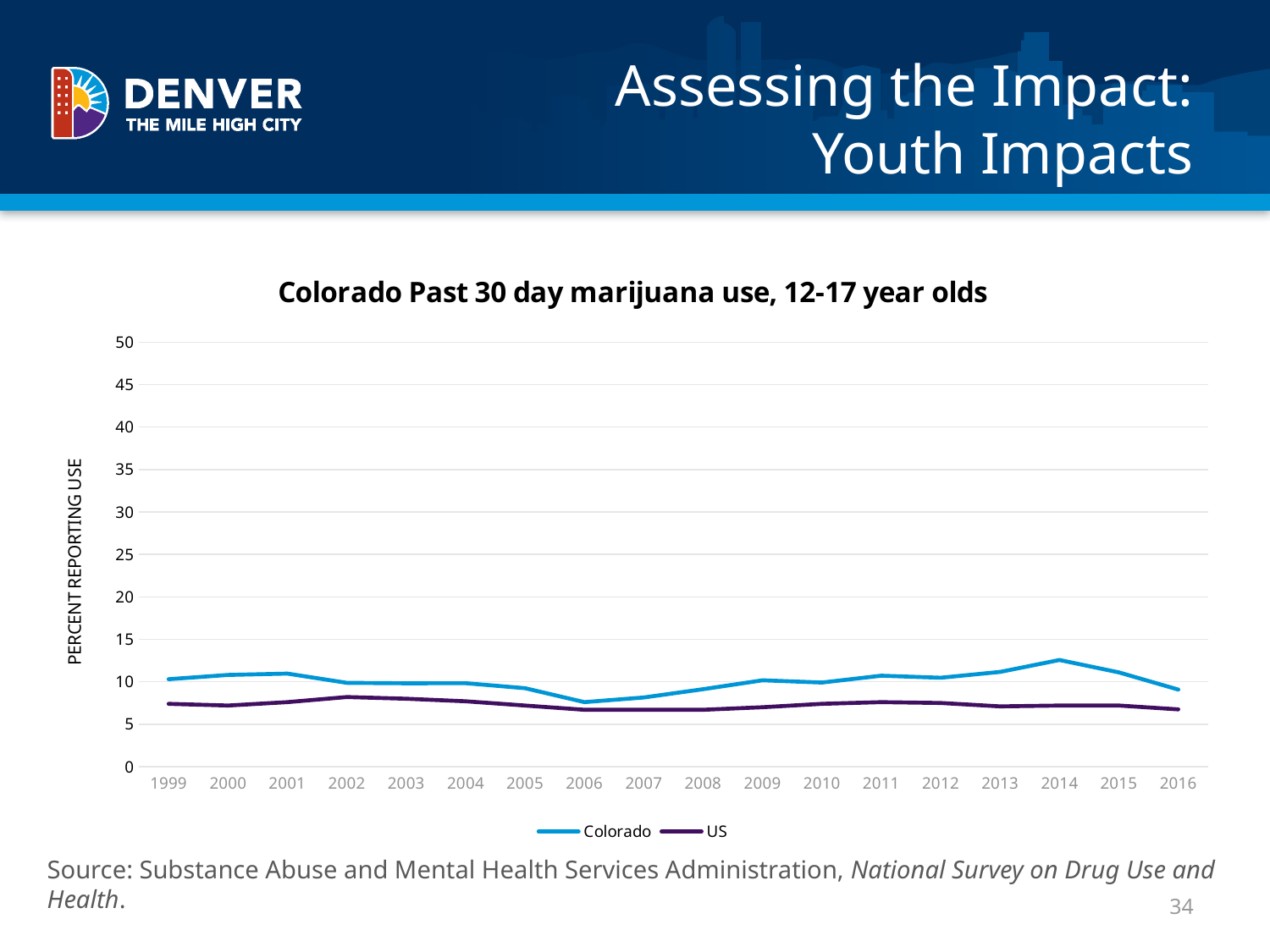
Which two series are shown in the legend? Colorado and US In which year does the Colorado line reach its lowest value? 2006 In 2014, which series has the higher value, Colorado or US? Colorado Does the Colorado line rise or fall from 2014 to 2016? fall Is the value for US in 2016 greater or less than 10? less Is the value for Colorado in 2006 greater or less than 10? less In which year does the Colorado line reach its highest value? 2014 How many series does the legend list? 2 How many years are plotted along the x axis? 18 What is the title of the chart? Colorado Past 30 day marijuana use, 12-17 year olds Is the value for Colorado in 2014 greater or less than 10? greater What kind of chart is shown on the slide? line chart